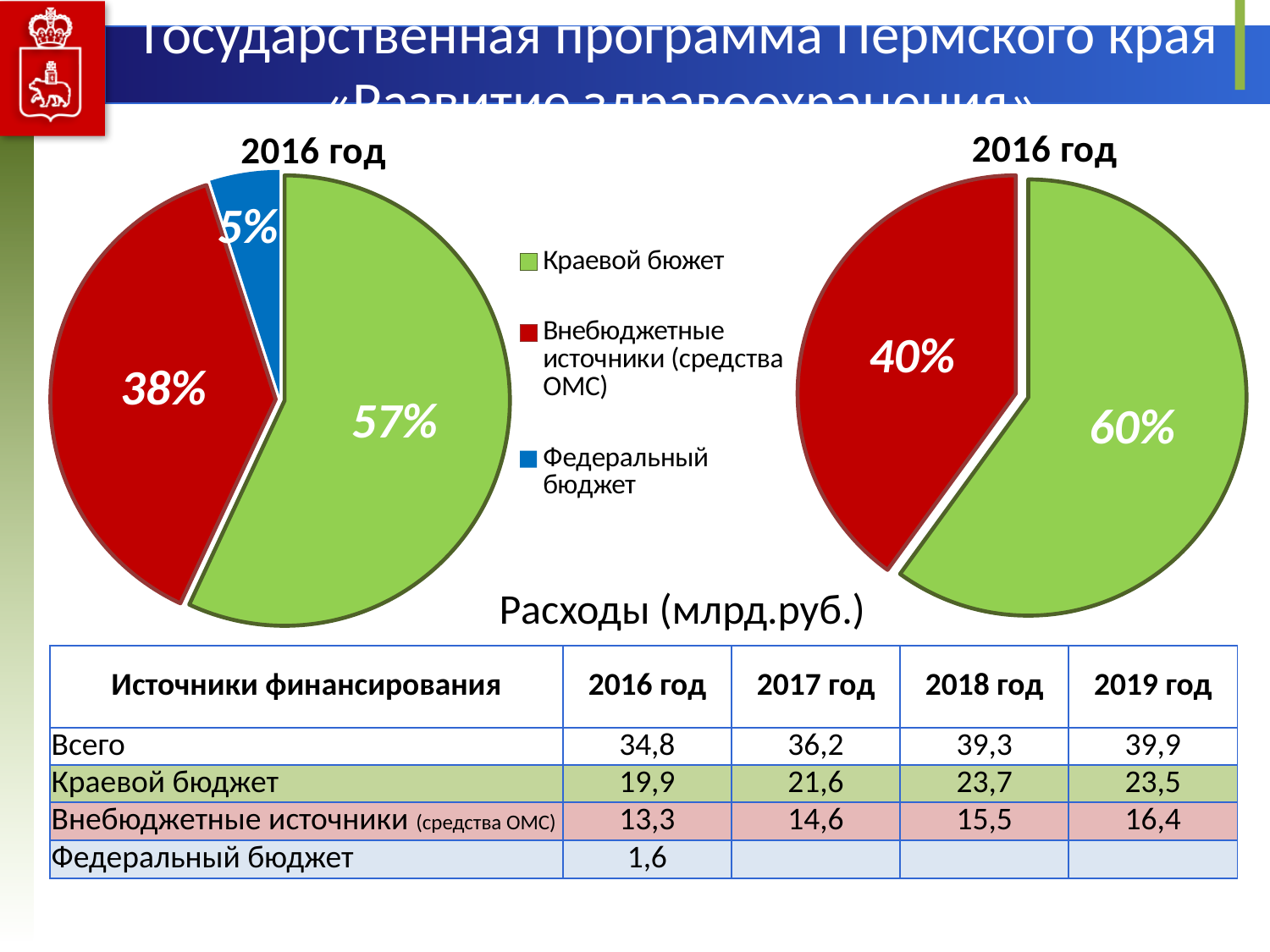
In the right pie chart, what is the difference in percentage points between the green and red slices? 20 In the left pie chart, what share does Федеральный бюджет have? 5% In the left pie chart, how many slices are there? 3 What colour represents Федеральный бюджет in the legend? blue In the left pie chart, what share does Краевой бюджет have? 57% In the left pie chart, which source has the largest share? Краевой бюджет In the left pie chart, what share does Внебюджетные источники (средства ОМС) have? 38% What kind of chart is the left chart on the slide? pie chart In the left pie chart, which source has the smallest share? Федеральный бюджет How many entries does the legend between the two pie charts list? 3